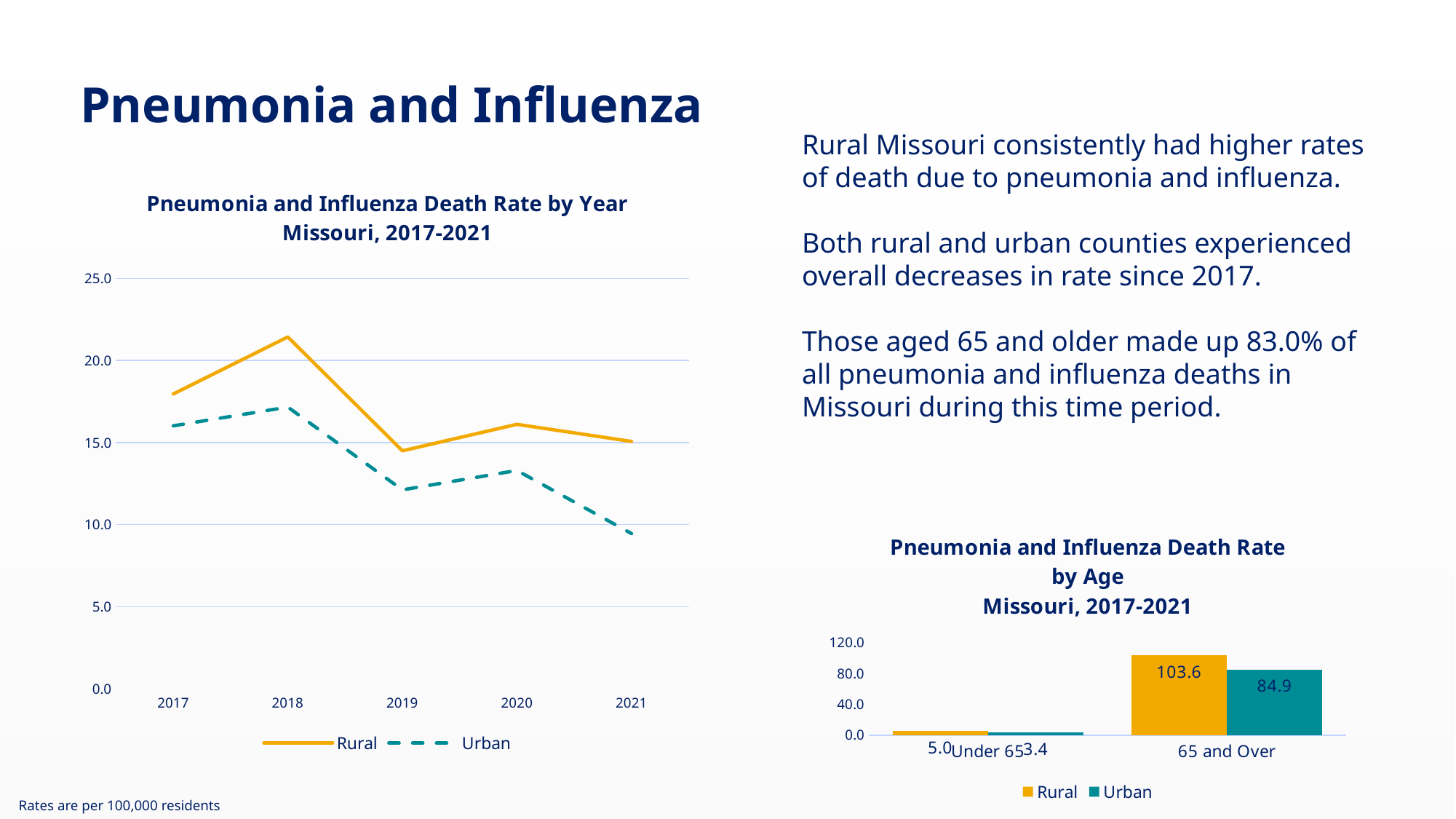
In the 'Pneumonia and Influenza Death Rate by Age' chart, how many age categories are shown? 2 In the 'Pneumonia and Influenza Death Rate by Year' chart, in which year is the Rural rate highest? 2018 In the 'Pneumonia and Influenza Death Rate by Age' chart, what is the Urban value for Under 65? 3.4 In the 'Pneumonia and Influenza Death Rate by Year' chart, is the Urban value for 2021 greater or less than 10.0? less In the 'Pneumonia and Influenza Death Rate by Year' chart, how many series does the legend list? 2 In the 'Pneumonia and Influenza Death Rate by Year' chart, in which year is the Urban rate lowest? 2021 What kind of chart is 'Pneumonia and Influenza Death Rate by Age'? Bar chart In the 'Pneumonia and Influenza Death Rate by Age' chart, which is larger for Under 65, Rural or Urban? Rural In the 'Pneumonia and Influenza Death Rate by Age' chart, what is the Rural value for 65 and Over? 103.6 In the 'Pneumonia and Influenza Death Rate by Age' chart, what is the difference between the Rural and Urban values for 65 and Over? 18.7 In the 'Pneumonia and Influenza Death Rate by Year' chart, does the Urban rate overall rise or fall from 2017 to 2021? Fall In the 'Pneumonia and Influenza Death Rate by Year' chart, is the Rural value for 2018 greater or less than 20.0? greater